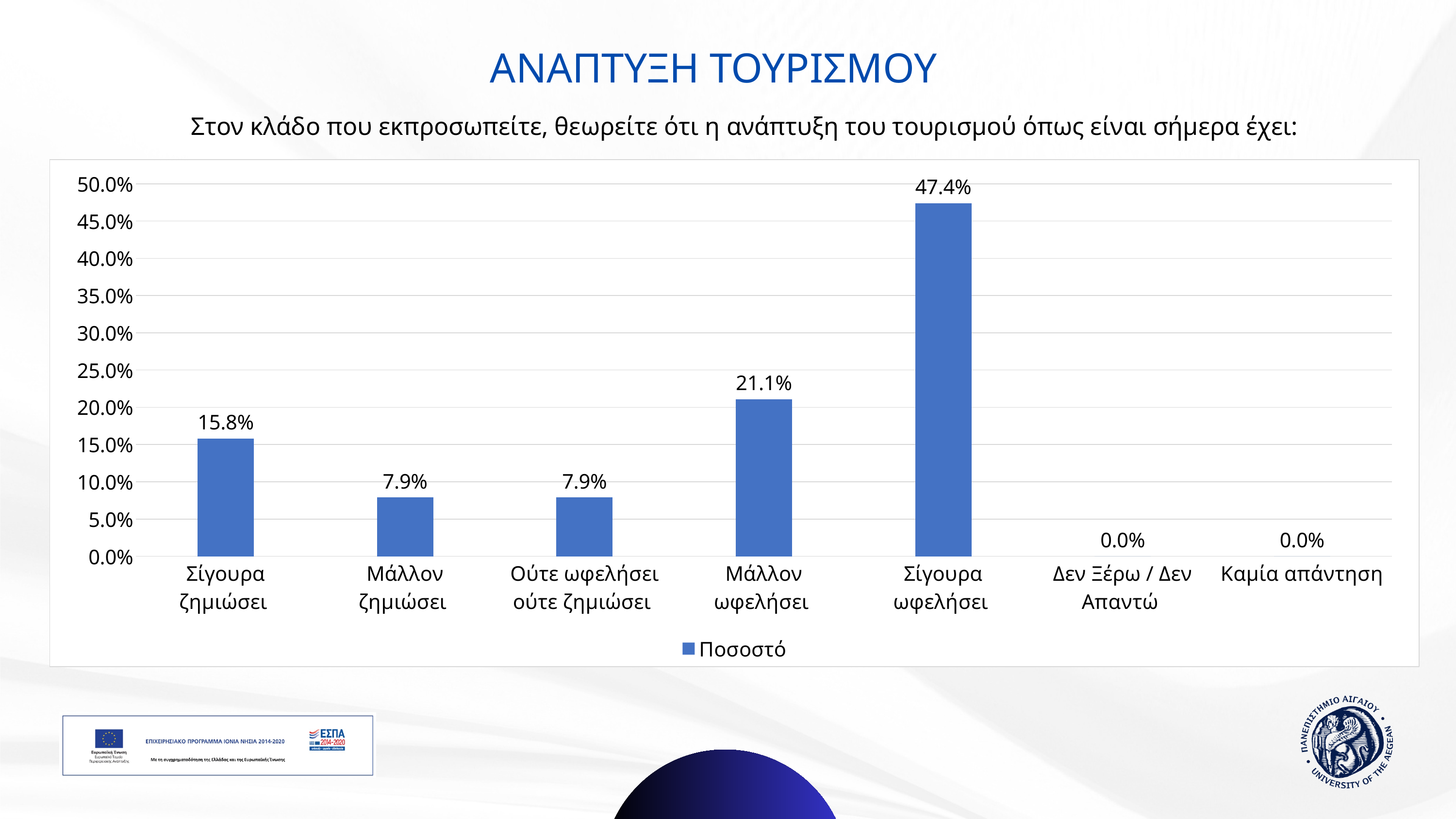
What is the difference between the values for Σίγουρα ωφελήσει and Μάλλον ωφελήσει? 26.3% What is the name of the series in the legend? Ποσοστό Which category has the highest value? Σίγουρα ωφελήσει Is the value for Μάλλον ωφελήσει greater or less than 20.0%? greater What is the value for Σίγουρα ζημιώσει? 15.8% What is the value for Ούτε ωφελήσει ούτε ζημιώσει? 7.9% What is the value for Σίγουρα ωφελήσει? 47.4% How many categories are shown on the x axis? 7 What is the value for Μάλλον ωφελήσει? 21.1% What kind of chart is shown on the slide? bar chart Which is larger, the value for Σίγουρα ζημιώσει or the value for Μάλλον ζημιώσει? Σίγουρα ζημιώσει How many series does the legend list? 1